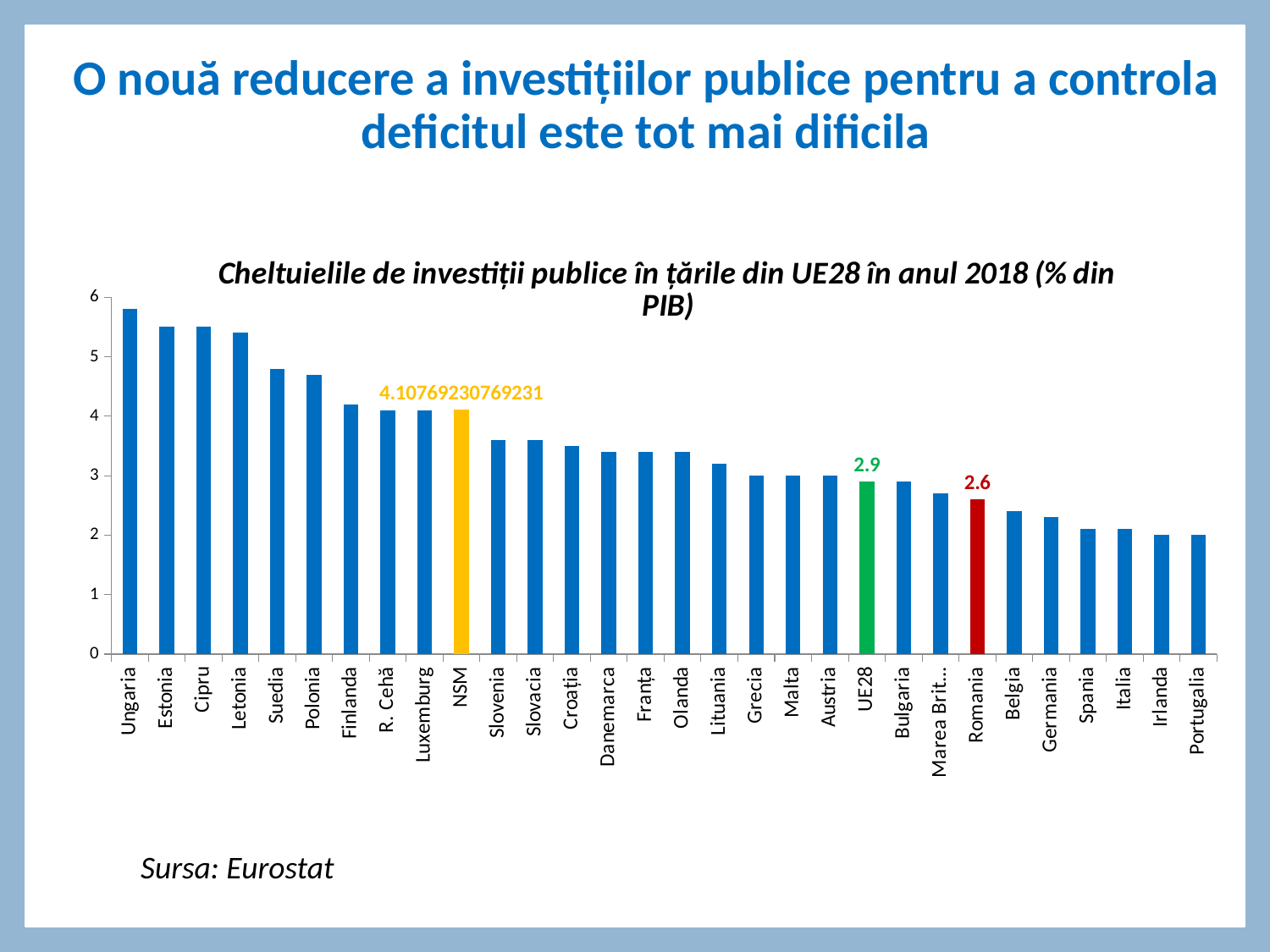
Which is larger, the value for UE28 or the value for Romania? UE28 What value is labelled on the bar for NSM? 4.10769230769231 What value is labelled on the bar for UE28? 2.9 Which country has the highest public investment spending in the chart? Ungaria Do the values rise or fall moving from left to right along the x axis? Fall What value is labelled on the bar for Romania? 2.6 Is the value for Portugalia greater or less than 3? less What is the difference between the labelled values for UE28 and Romania? 0.3 How many categories (bars) are shown in the chart? 30 Is the value for Ungaria greater or less than 5? greater What kind of chart is shown on the slide? Bar chart Is the value for Suedia greater or less than 4? greater